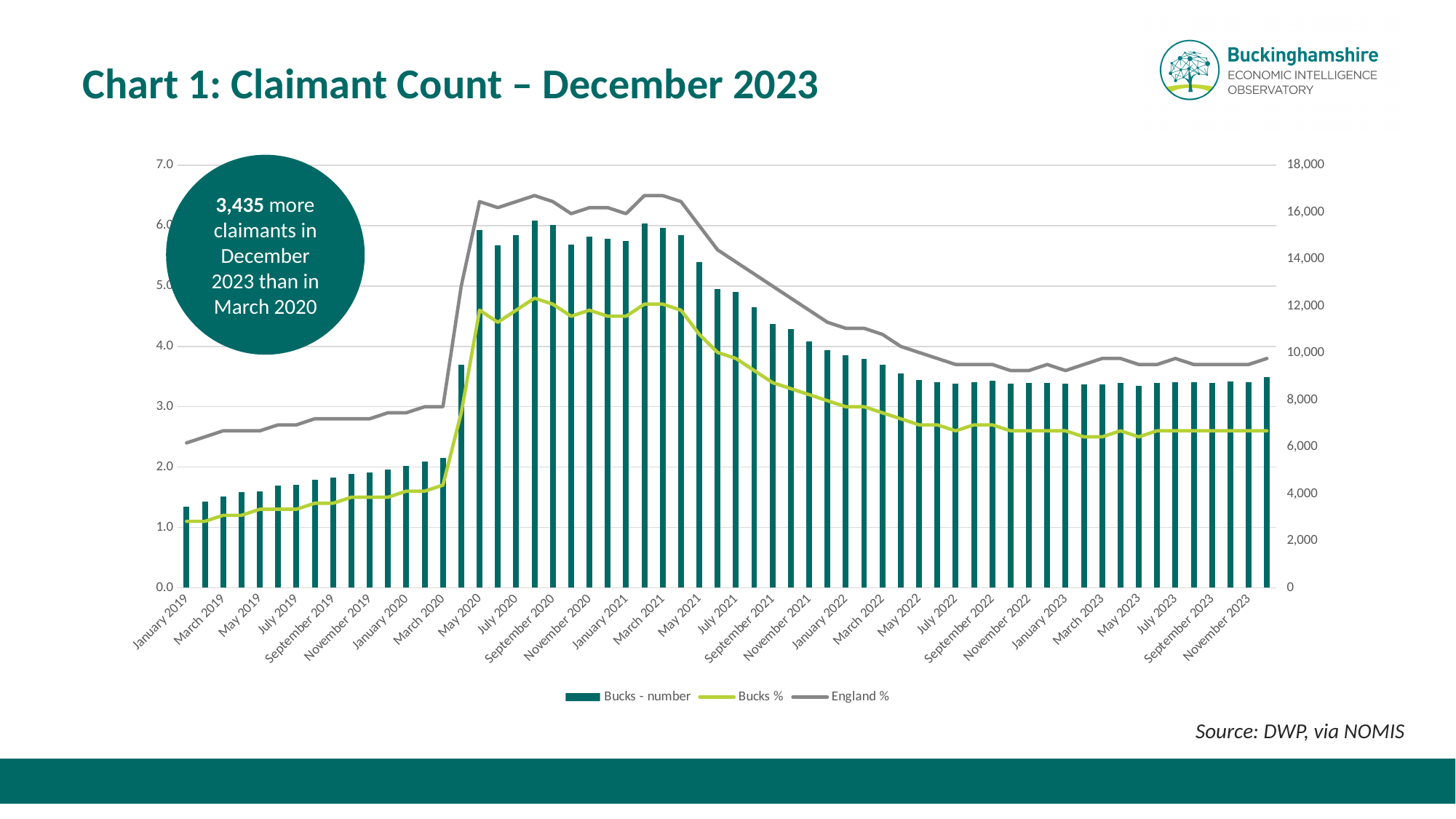
Is the Bucks - number value for January 2019 greater or less than 4,000? less According to the callout, how many more claimants were there in December 2023 than in March 2020? 3,435 What kind of chart is shown on the slide? Combined bar and line chart Is the England % value for May 2020 greater or less than 6.0? greater Is the England % value for January 2019 greater or less than 3.0? less Which series is plotted as bars? Bucks - number How many series does the legend list? 3 Does the Bucks % series rise or fall from April 2021 to December 2021? fall Does the Bucks - number series rise or fall from January 2019 to March 2020? rise In December 2023, which is higher, Bucks % or England %? England %